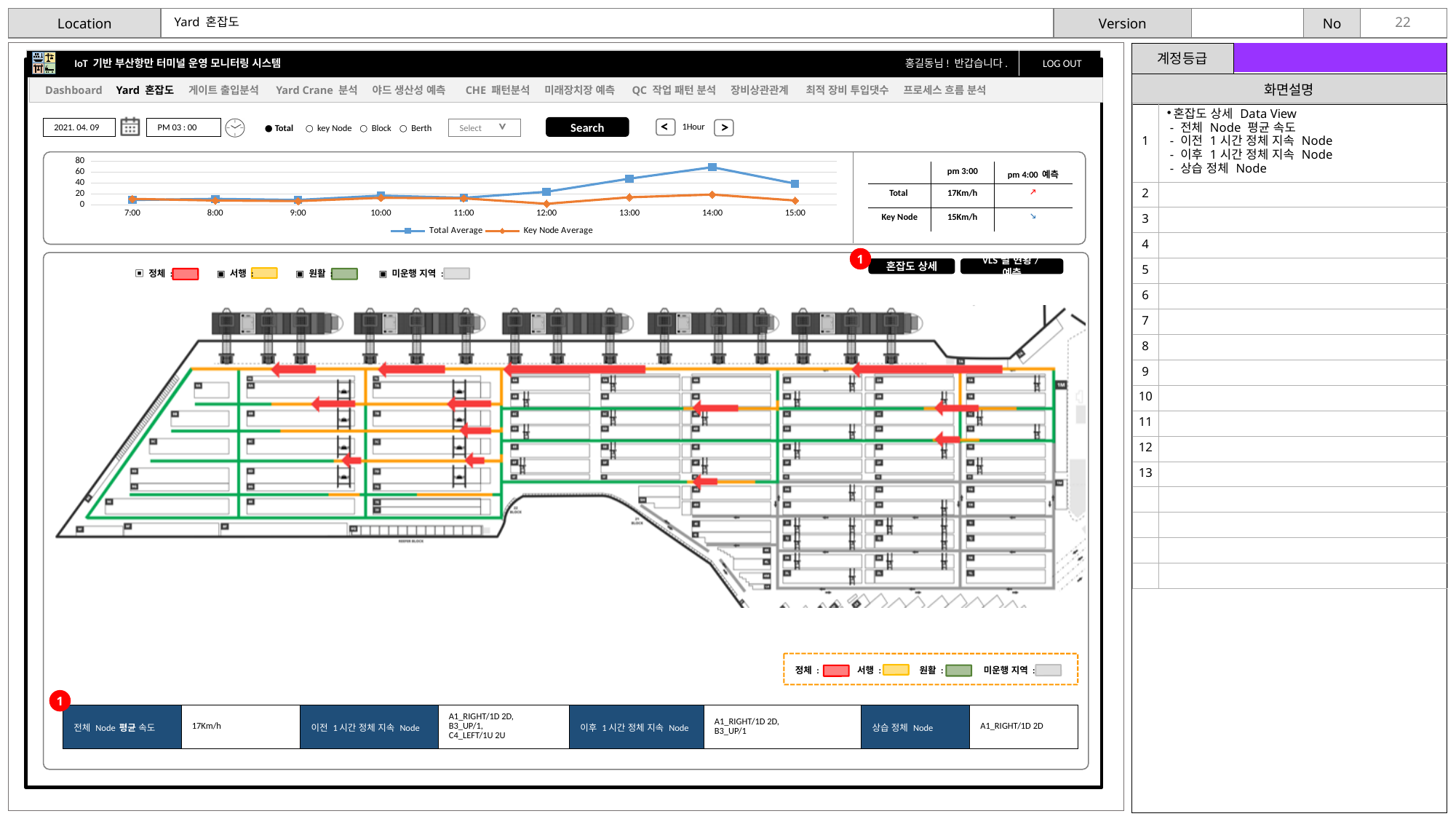
At 14:00, which series has the larger value, Total Average or Key Node Average? Total Average Does the Total Average series rise or fall between 14:00 and 15:00? fall What are the two series named in the chart legend? Total Average and Key Node Average At which time does the Total Average series reach its highest value? 14:00 Is the Total Average value at 8:00 greater or less than 40? less How many time points are plotted along the x axis of the chart? 9 Is the Total Average value at 14:00 greater or less than 40? greater What kind of chart is shown on the slide? line chart Is the Key Node Average value at 14:00 greater or less than 40? less What is the first time label shown on the x axis of the chart? 7:00 How many series does the chart legend list? 2 Does the Total Average series rise or fall between 12:00 and 14:00? rise